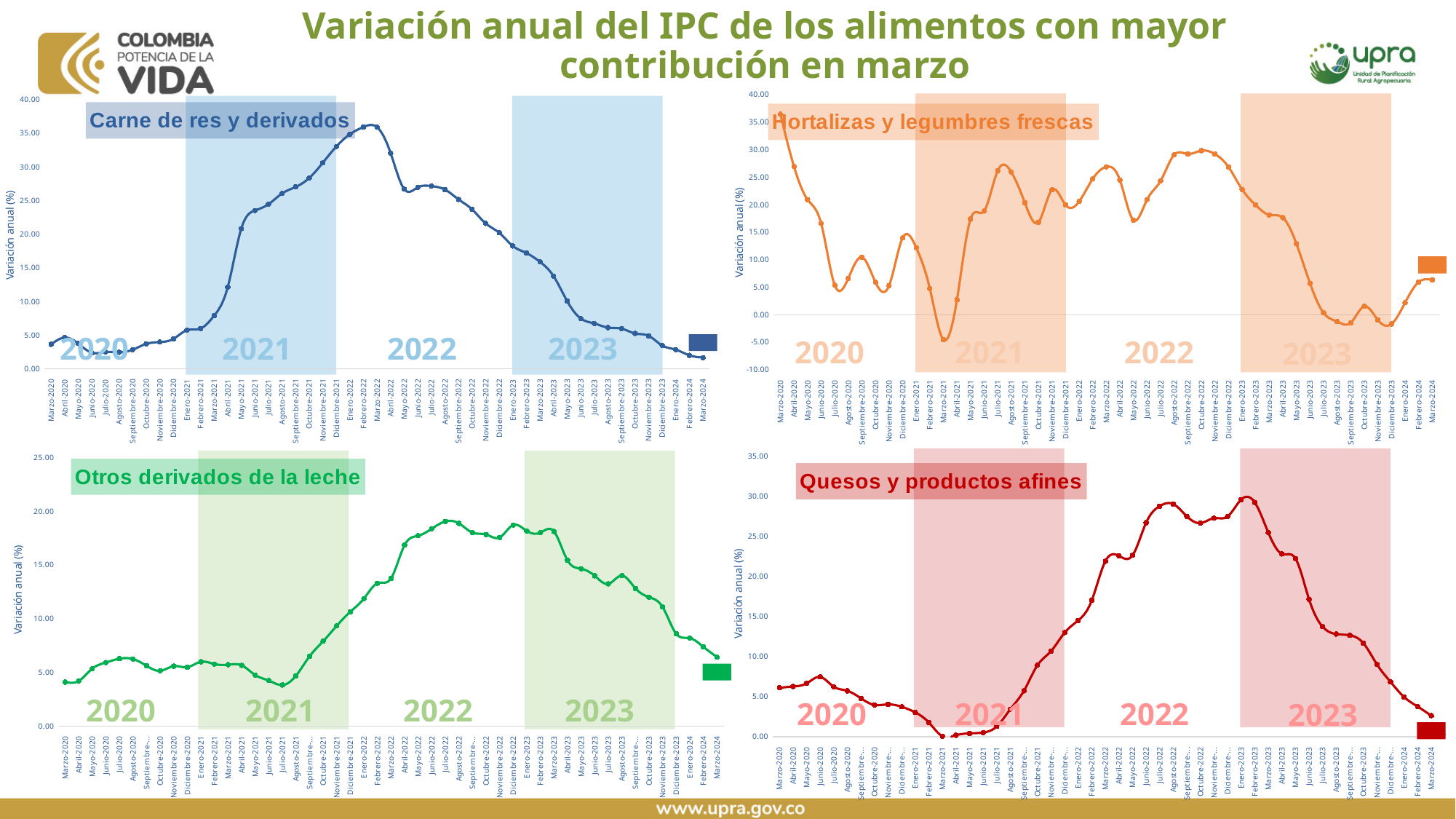
In the 'Hortalizas y legumbres frescas' chart, is the value for Marzo-2021 greater or less than 0? less In the 'Carne de res y derivados' chart, is the value for Marzo-2022 greater or less than 30? greater In the 'Otros derivados de la leche' chart, is the value for Julio-2022 greater or less than 15? greater How many charts are shown on the slide? 4 In the 'Quesos y productos afines' chart, do the values rise or fall from Marzo-2021 to Febrero-2023? rise In the 'Carne de res y derivados' chart, do the values rise or fall from Marzo-2022 to Marzo-2024? fall In the 'Carne de res y derivados' chart, which is larger, the value for Marzo-2022 or the value for Marzo-2024? Marzo-2022 Which chart on the slide shows values that drop below 0? Hortalizas y legumbres frescas What kind of chart is the 'Carne de res y derivados' chart? line chart